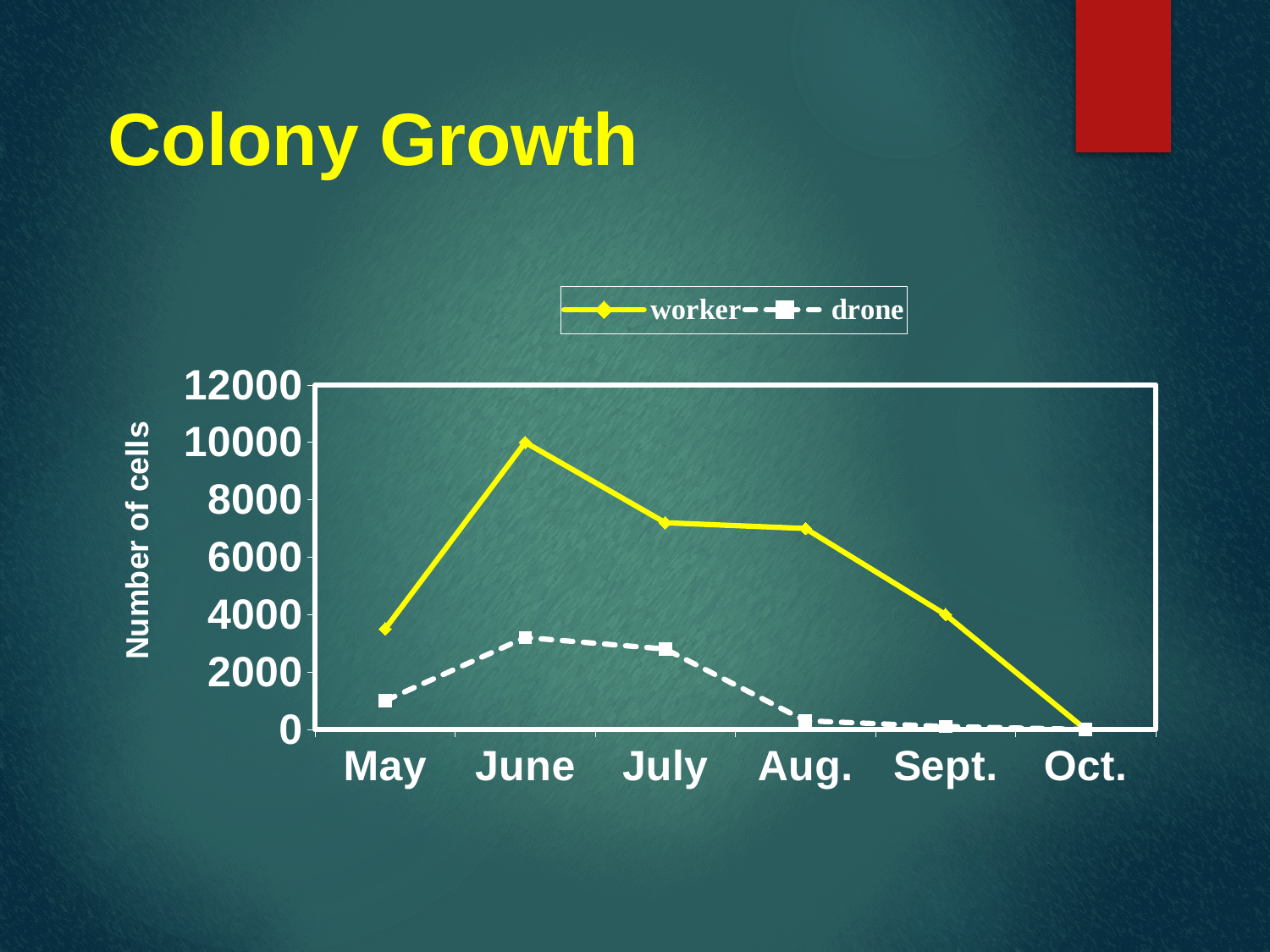
Is the value for worker in May greater or less than 2000? greater In July, which series has the larger value, worker or drone? worker How many series does the legend list? 2 In which month does the worker series reach its highest value? June What kind of chart is shown on the slide? line chart Is the value for drone in June greater or less than 4000? less Is the value for worker in July greater or less than 8000? less What is the title of the y axis? Number of cells What is the value of the worker series in June? 10000 In which month is the worker series at its lowest value? Oct. In which month does the drone series reach its highest value? June How many months are plotted along the x axis? 6